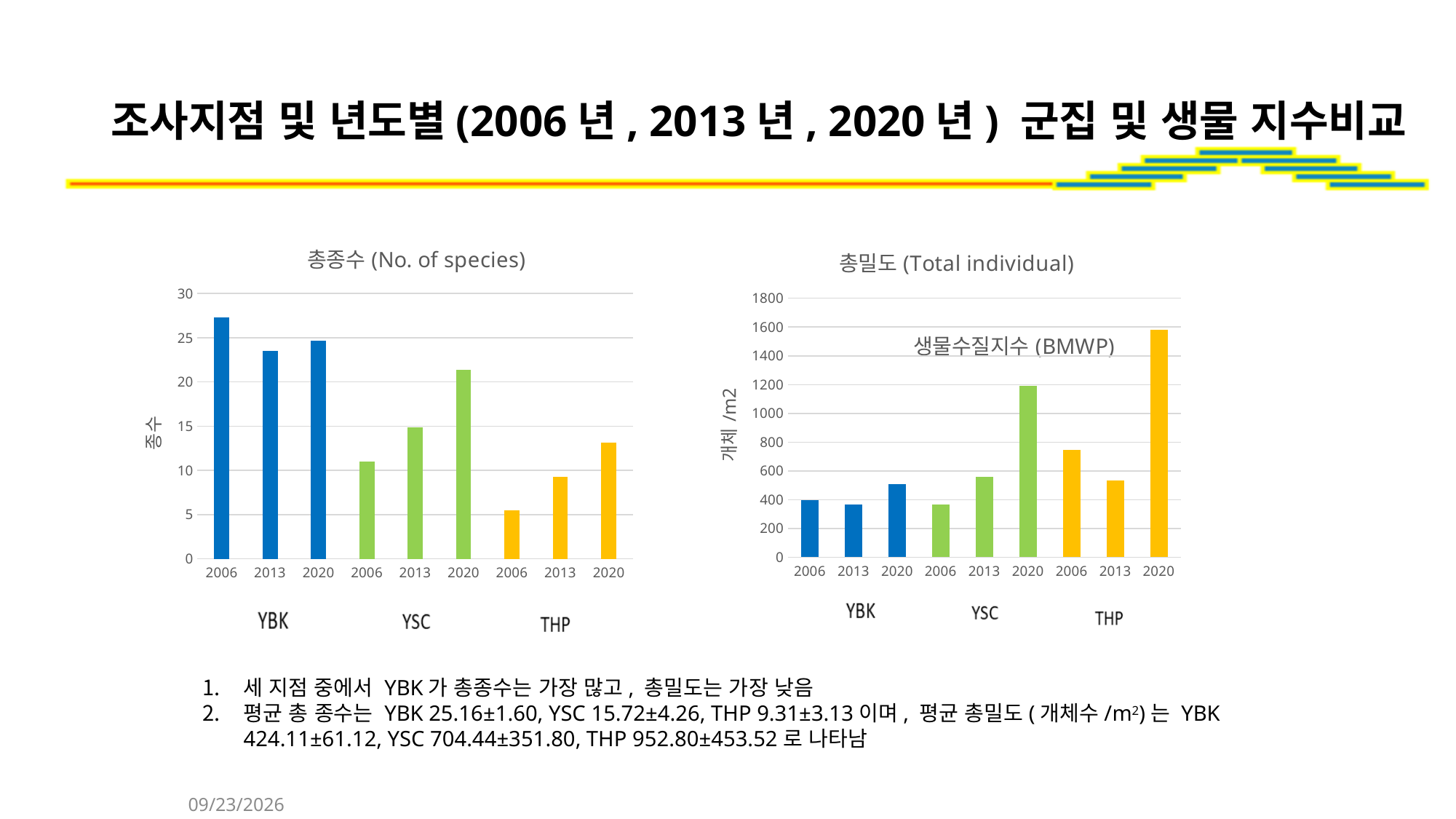
In the '총밀도 (Total individual)' chart, is the value for YSC 2020 greater or less than 1000? greater In the '총종수 (No. of species)' chart, which site and year has the highest value? YBK 2006 In the '총종수 (No. of species)' chart, how many bars are plotted? 9 In the '총밀도 (Total individual)' chart, is the value for YBK 2020 greater or less than 600? less In the '총종수 (No. of species)' chart, which site and year has the lowest value? THP 2006 What is the y-axis label of the '총밀도 (Total individual)' chart? 개체 /m2 What kind of chart is the '총종수 (No. of species)' chart on the left? bar chart In the '총밀도 (Total individual)' chart, which is larger: THP 2006 or YSC 2013? THP 2006 In the '총종수 (No. of species)' chart, is the value for YSC 2020 greater or less than 20? greater In the '총종수 (No. of species)' chart, do the THP values rise or fall from 2006 to 2020? rise In the '총밀도 (Total individual)' chart, which site and year has the highest value? THP 2020 In the '총종수 (No. of species)' chart, which is larger: YSC 2013 or THP 2020? YSC 2013